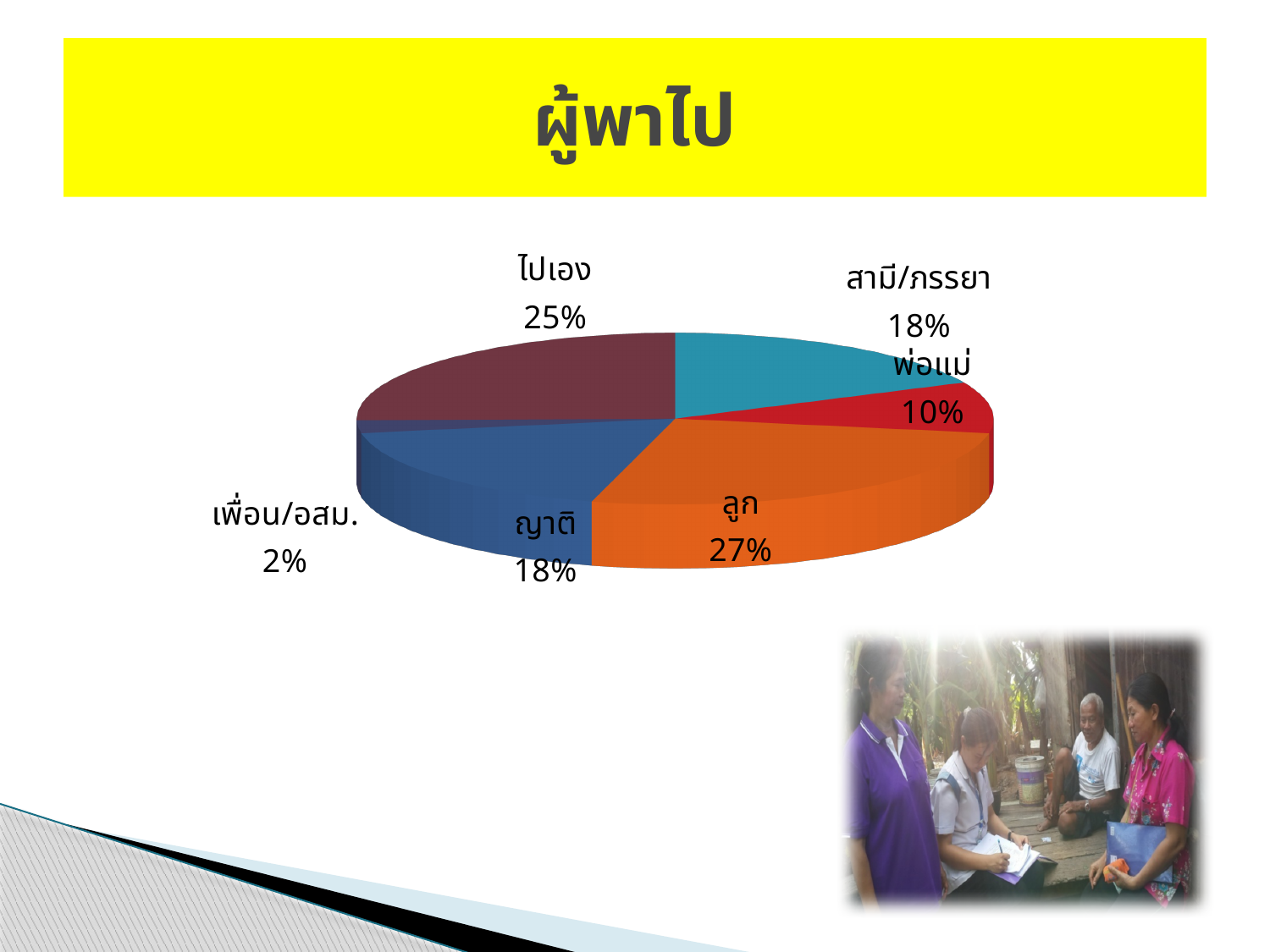
How many categories are shown in the pie chart? 6 What percentage of the pie chart is labelled ไปเอง? 25% Which is larger, the share for ไปเอง or the share for พ่อแม่? ไปเอง What is the difference in percentage points between ลูก and ไปเอง? 2 What percentage of the pie chart is labelled พ่อแม่? 10% What is the title of the slide containing the chart? ผู้พาไป What kind of chart is shown on the slide? Pie chart What percentage of the pie chart is labelled เพื่อน/อสม.? 2% What percentage of the pie chart is labelled สามี/ภรรยา? 18% Which category has the smallest share of the pie chart? เพื่อน/อสม. What percentage of the pie chart is labelled ลูก? 27% Which category has the largest share of the pie chart? ลูก